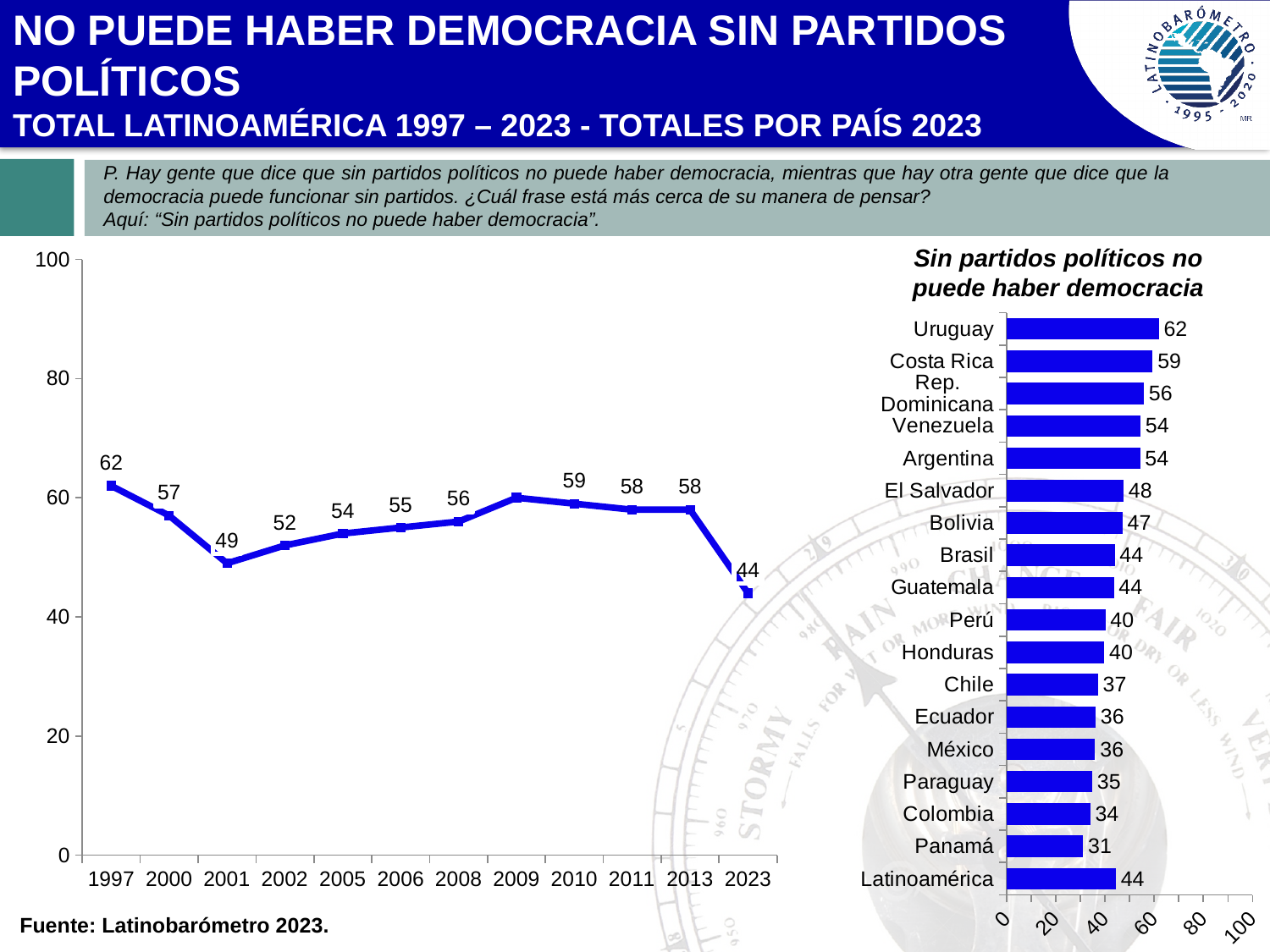
In the line chart on the left, which year has the lowest value? 2023 What kind of chart is the chart on the left? line chart In the bar chart 'Sin partidos políticos no puede haber democracia', what is the value for Costa Rica? 59 In the line chart on the left, is the value for 2001 greater or less than 60? less In the bar chart 'Sin partidos políticos no puede haber democracia', what is the value for Latinoamérica? 44 In the line chart on the left, what is the difference between the 1997 value and the 2023 value? 18 In the bar chart 'Sin partidos políticos no puede haber democracia', which country has the lowest value? Panamá In the line chart on the left, what is the value for 1997? 62 In the bar chart 'Sin partidos políticos no puede haber democracia', what is the difference between Uruguay and Panamá? 31 In the bar chart 'Sin partidos políticos no puede haber democracia', which country has the highest value? Uruguay In the bar chart 'Sin partidos políticos no puede haber democracia', which is larger, the value for Chile or the value for Bolivia? Bolivia In the line chart on the left, what is the value for 2023? 44